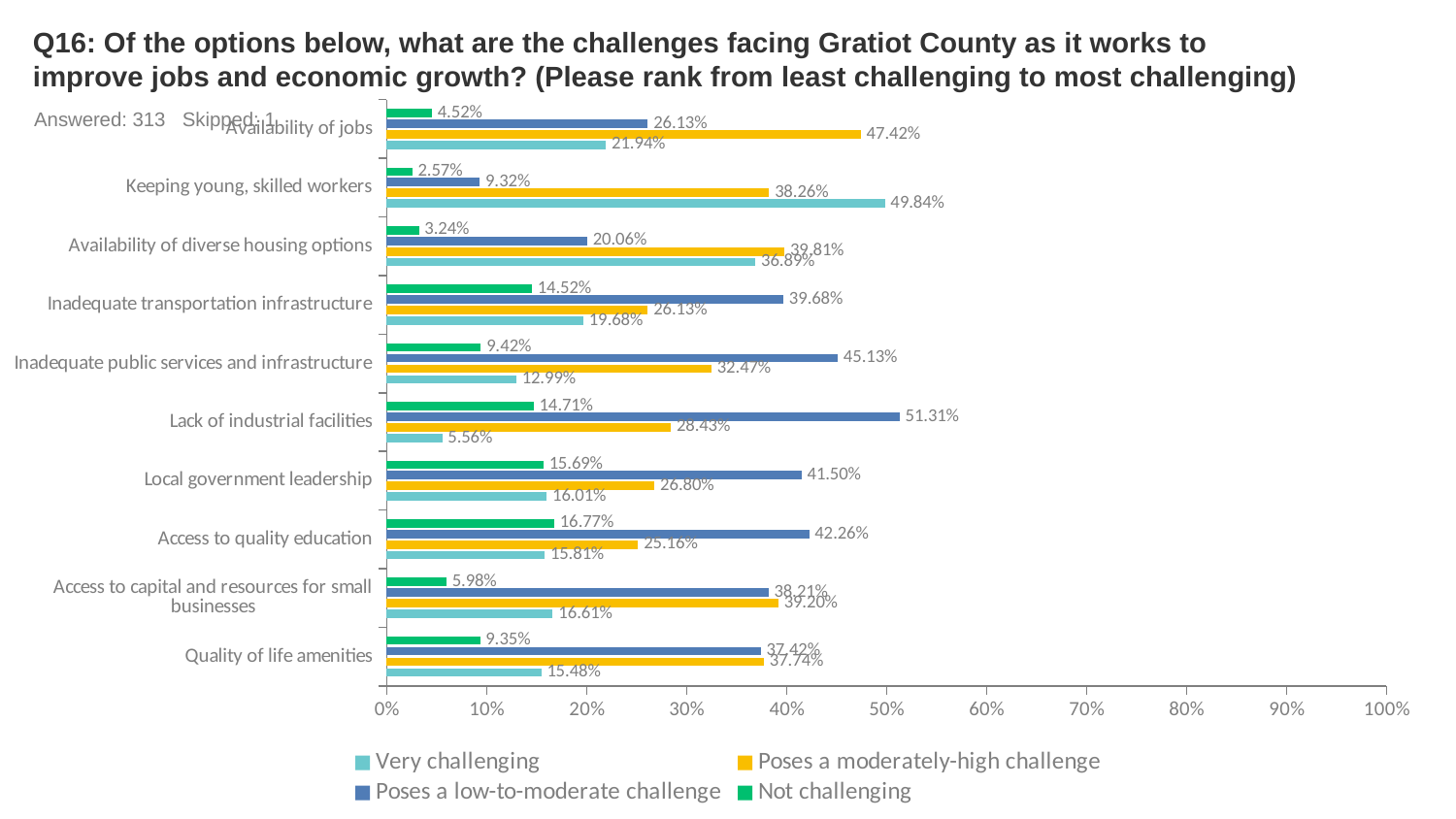
What type of chart is shown on the slide? bar chart What is the difference between the 'Poses a low-to-moderate challenge' value for 'Inadequate public services and infrastructure' (45.13%) and its 'Poses a moderately-high challenge' value (32.47%)? 12.66% How many series does the legend list? 4 What is the 'Poses a low-to-moderate challenge' value for 'Lack of industrial facilities'? 51.31% Which category has the highest 'Very challenging' value? Keeping young, skilled workers Which is larger for 'Local government leadership': the 'Poses a low-to-moderate challenge' value or the 'Poses a moderately-high challenge' value? Poses a low-to-moderate challenge How many categories (challenges) are plotted on the chart? 10 Which category has the lowest 'Not challenging' value? Keeping young, skilled workers What is the 'Poses a moderately-high challenge' value for 'Availability of jobs'? 47.42% What is the 'Very challenging' value for 'Keeping young, skilled workers'? 49.84% Is the 'Very challenging' value for 'Lack of industrial facilities' greater or less than 10%? less What is the 'Not challenging' value for 'Access to quality education'? 16.77%